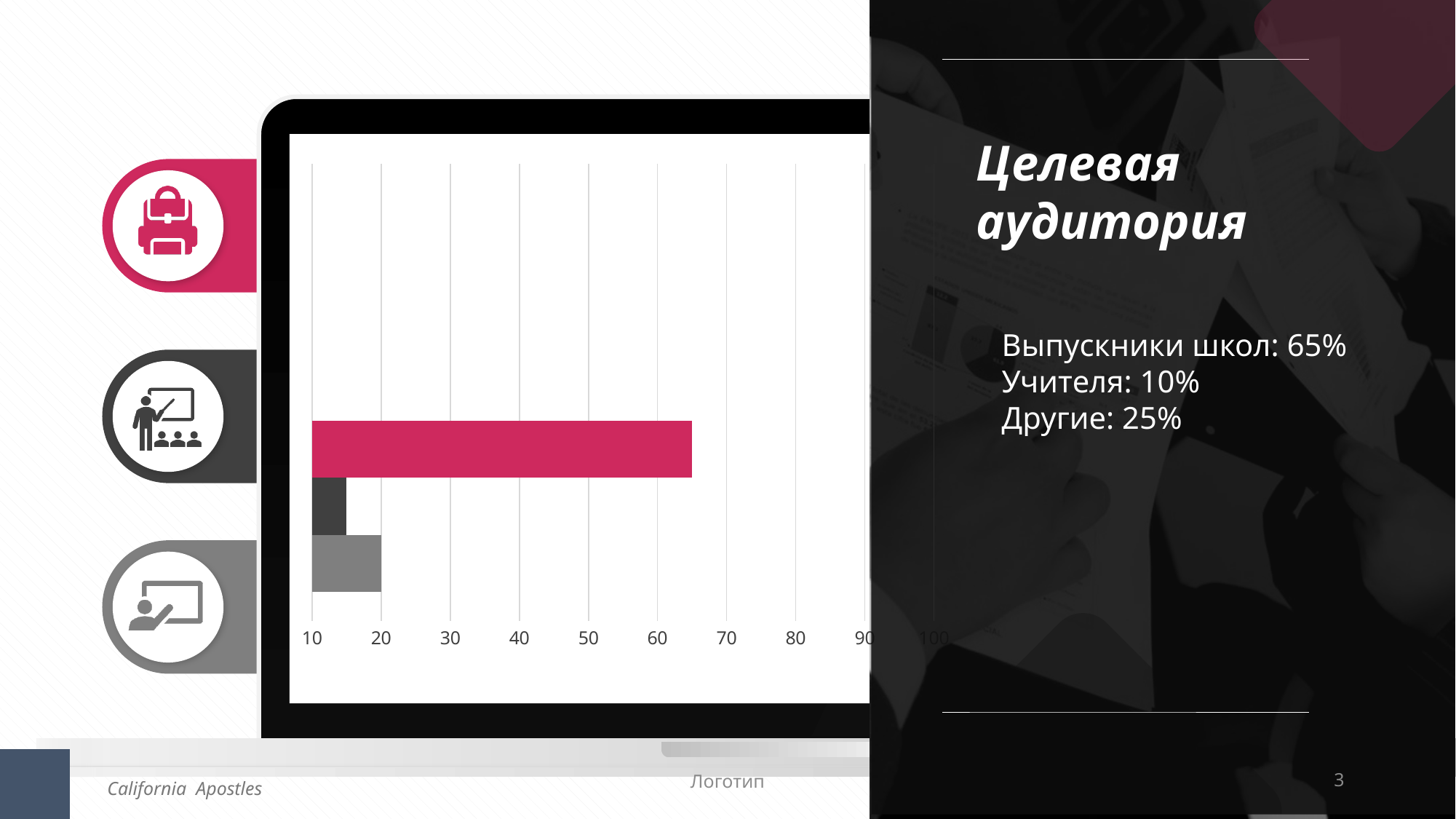
What value does the light gray bar reach on the horizontal axis? 20 Is the value of the dark gray bar greater or less than 10? greater Is the value of the dark gray bar greater or less than 20? less Is the value of the pink bar greater or less than 70? less Which is larger, the light gray bar or the dark gray bar? the light gray bar What colour is the longest bar in the chart? pink What is the highest tick value shown on the horizontal axis of the chart? 100 What kind of chart is shown on the slide? bar chart Which bar in the chart is the longest? the pink bar How many bars are plotted in the chart? 3 Which bar in the chart is the shortest? the dark gray bar